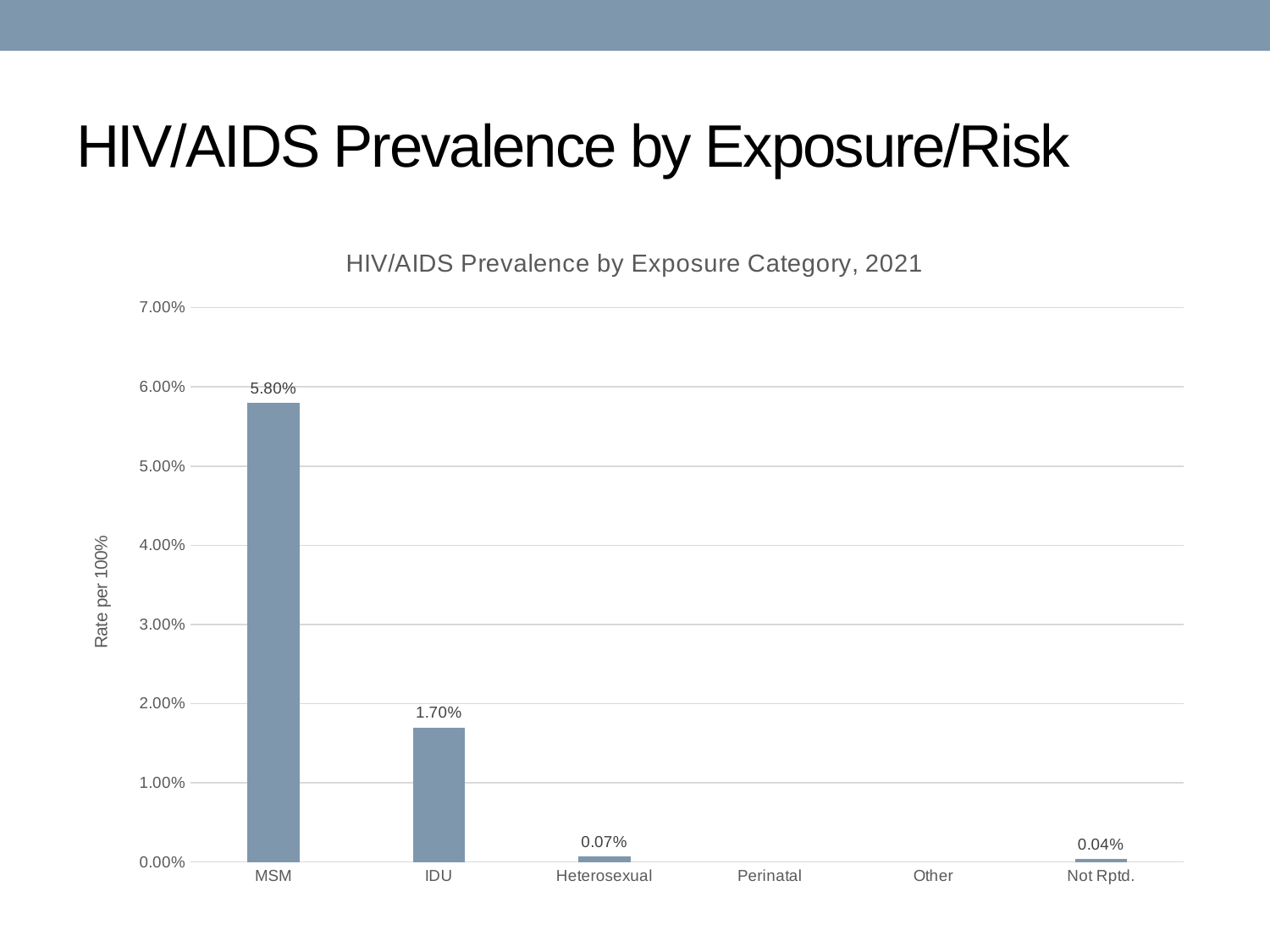
What is the value for Not Rptd.? 0.04% What kind of chart is shown on the slide? bar chart What is the title of the chart? HIV/AIDS Prevalence by Exposure Category, 2021 What is the difference between the values for MSM and IDU? 4.10% What is the value for IDU? 1.70% Which exposure category has the highest prevalence? MSM How many exposure categories are shown on the x axis? 6 What is the value for Heterosexual? 0.07% Which is larger, the value for IDU or the value for Heterosexual? IDU What is the value for MSM? 5.80% Is the value for MSM greater or less than 5.00%? greater What is the label of the vertical axis? Rate per 100%